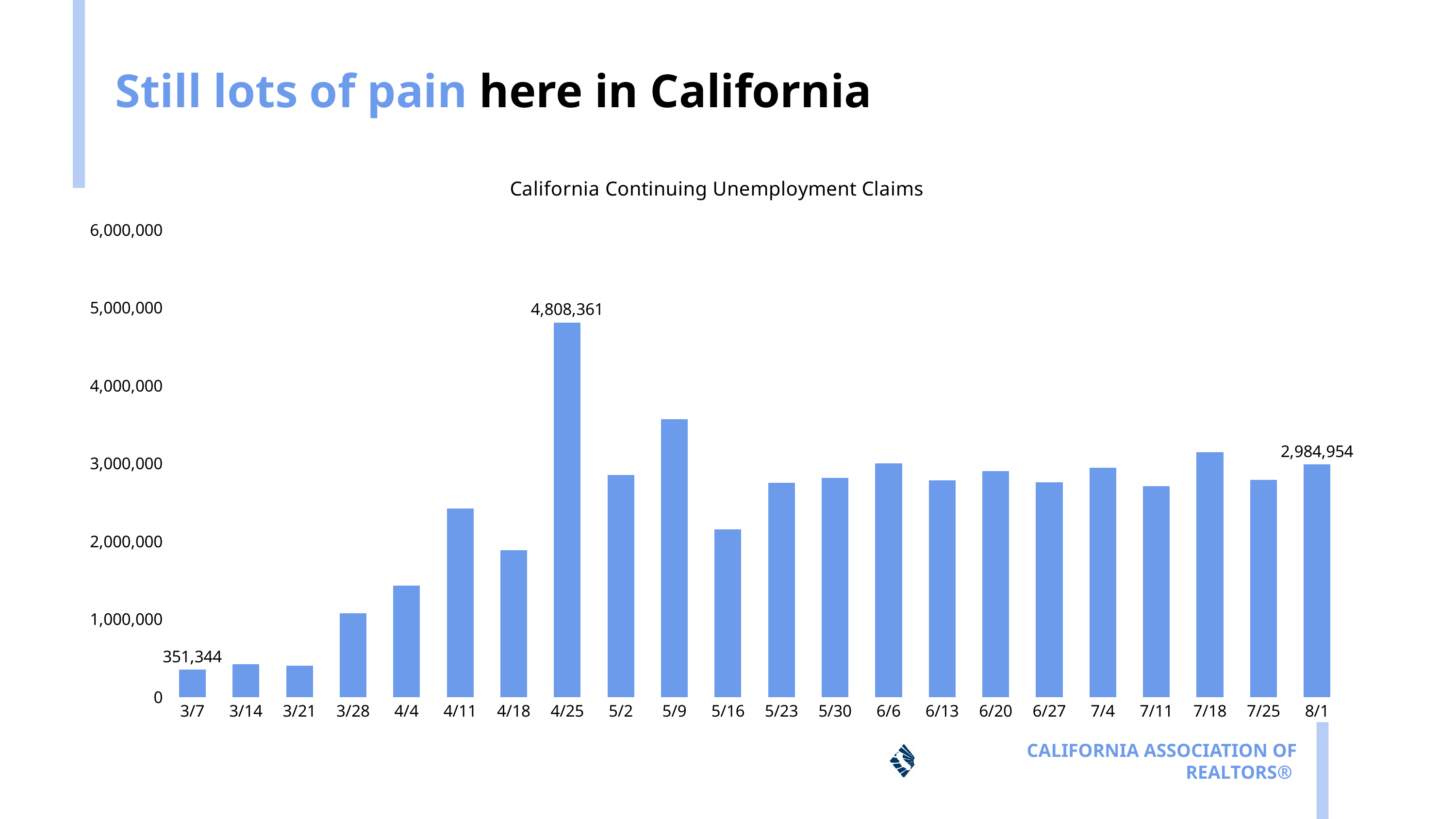
What is the difference between the claims on 4/25 and on 8/1? 1,823,407 How many weeks (bars) are shown on the chart? 22 Is the value for 4/4 greater or less than 2,000,000? less What is the difference between the claims on 8/1 and on 3/7? 2,633,610 Which is larger, the value for 5/9 or the value for 5/16? 5/9 What is the value of continuing unemployment claims for 8/1? 2,984,954 What is the value of continuing unemployment claims for 4/25? 4,808,361 What type of chart is shown on the slide? Bar chart What is the value of continuing unemployment claims for 3/7? 351,344 Which week has the highest number of continuing unemployment claims? 4/25 Is the value for 5/9 greater or less than 3,000,000? greater What is the title of the chart? California Continuing Unemployment Claims